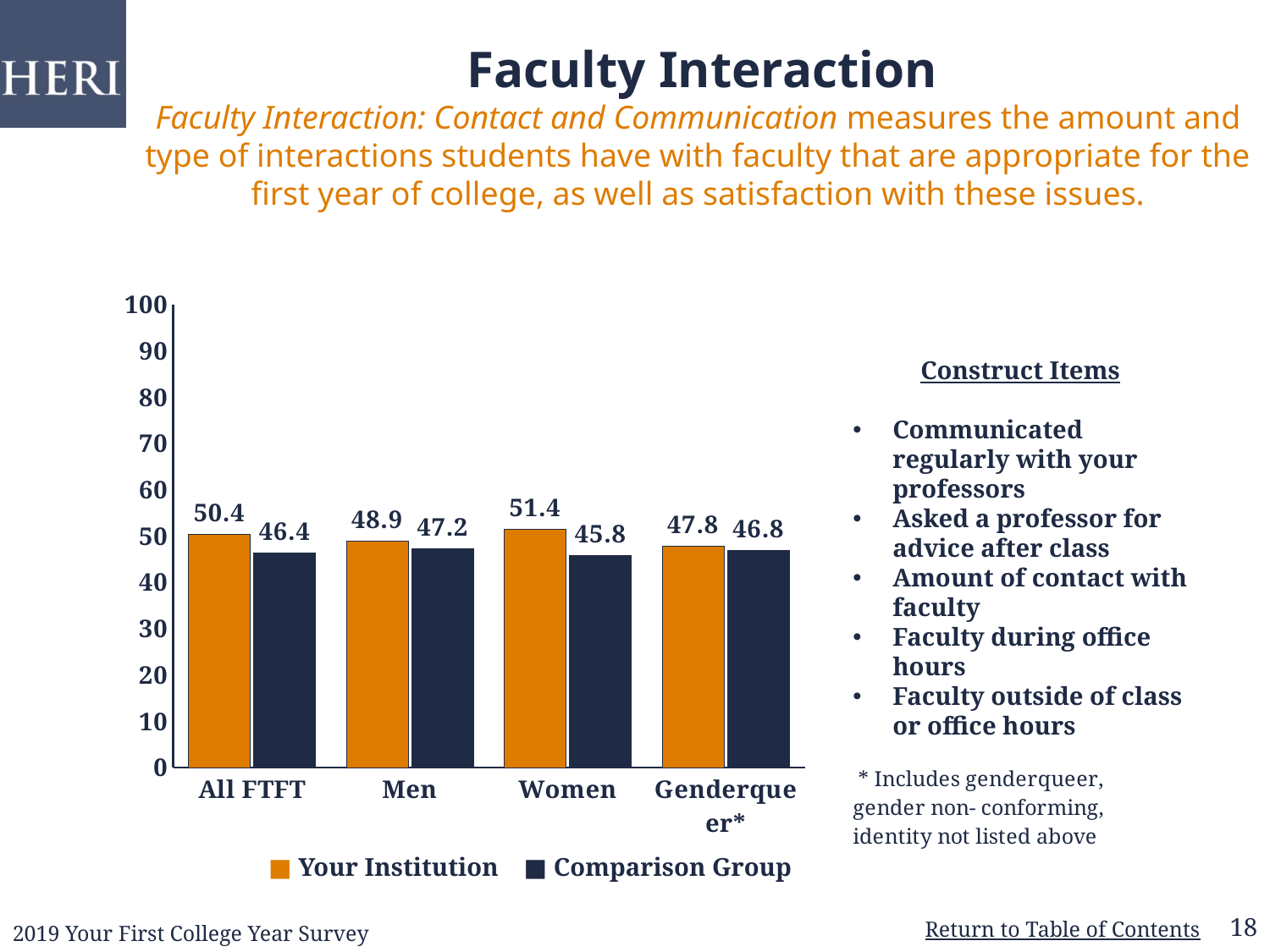
What is the difference between the Your Institution and Comparison Group values for Women? 5.6 Which is larger for Men: the Your Institution value or the Comparison Group value? Your Institution What is the Your Institution value for All FTFT? 50.4 What is the Comparison Group value for Men? 47.2 Which category has the highest Your Institution value? Women How many categories are shown on the x axis? 4 Is the Your Institution value for Genderqueer* greater or less than 50? less What is the Your Institution value for Women? 51.4 What is the Comparison Group value for Genderqueer*? 46.8 Which category has the lowest Comparison Group value? Women What kind of chart is shown on the slide? bar chart How many series does the legend list? 2